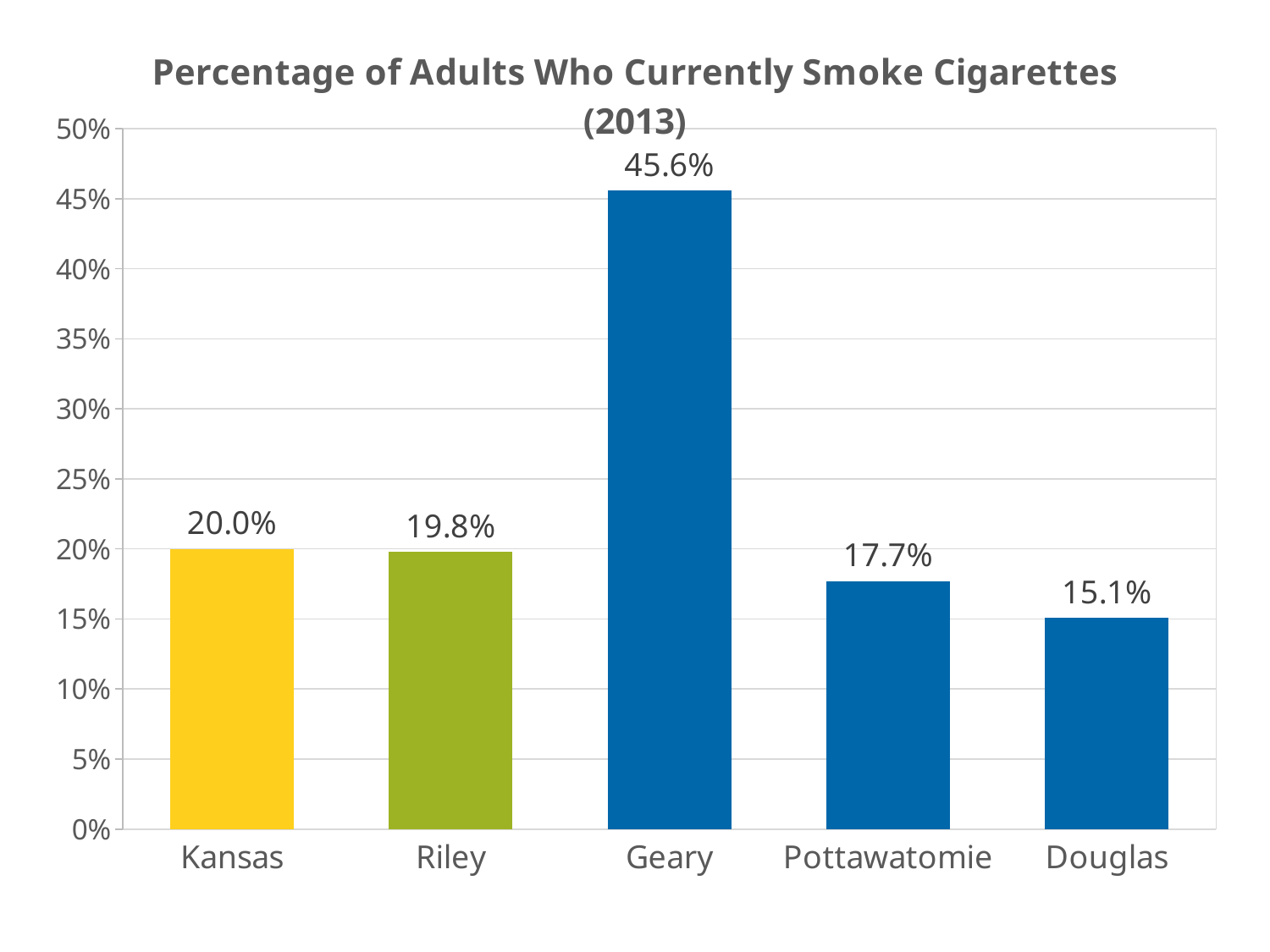
Which category has the highest percentage of adults who currently smoke? Geary What is the difference between the values for Riley and Douglas? 4.7% Which category has the lowest percentage of adults who currently smoke? Douglas What is the percentage of adults who currently smoke cigarettes in Geary? 45.6% What is the value shown for Douglas? 15.1% What is the difference between the values for Geary and Kansas? 25.6% Is the value for Geary greater or less than 40%? greater Which has a higher value, Pottawatomie or Douglas? Pottawatomie What kind of chart is shown on the slide? Bar chart What is the value shown for Pottawatomie? 17.7% How many categories are shown on the x axis? 5 What is the value shown for Kansas? 20.0%